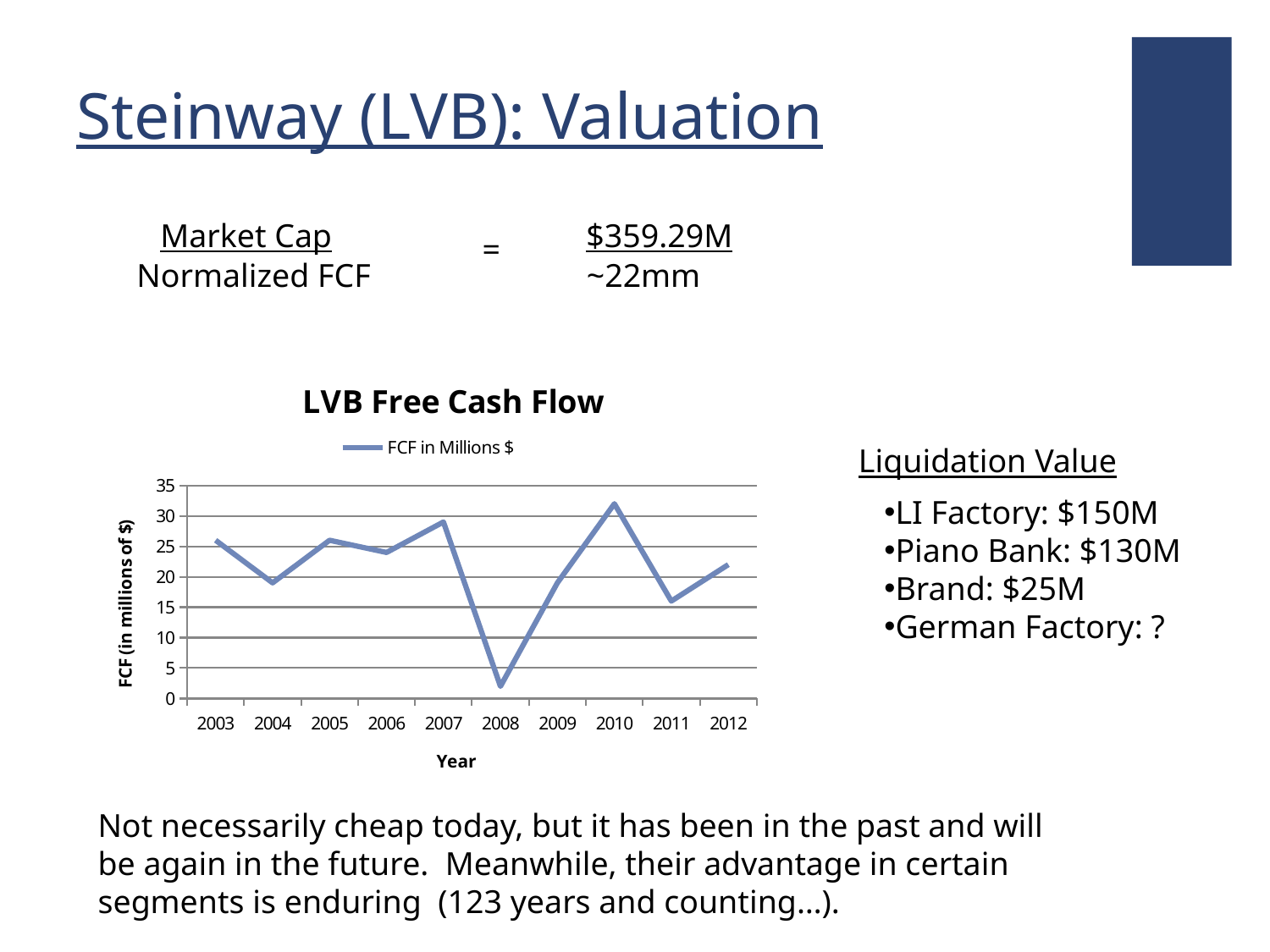
Is the value for 2010 greater or less than 30? greater Is the value for 2008 greater or less than 5? less Is the value for 2007 greater or less than 25? greater How many years are plotted on the x axis of the chart? 10 What is the title of the chart? LVB Free Cash Flow Which year has the highest free cash flow in the chart? 2010 How many series does the chart's legend list? 1 Which year has the larger free cash flow, 2007 or 2004? 2007 What kind of chart is shown on the slide? line chart Which year has the lowest free cash flow in the chart? 2008 Does the free cash flow rise or fall from 2007 to 2008? fall